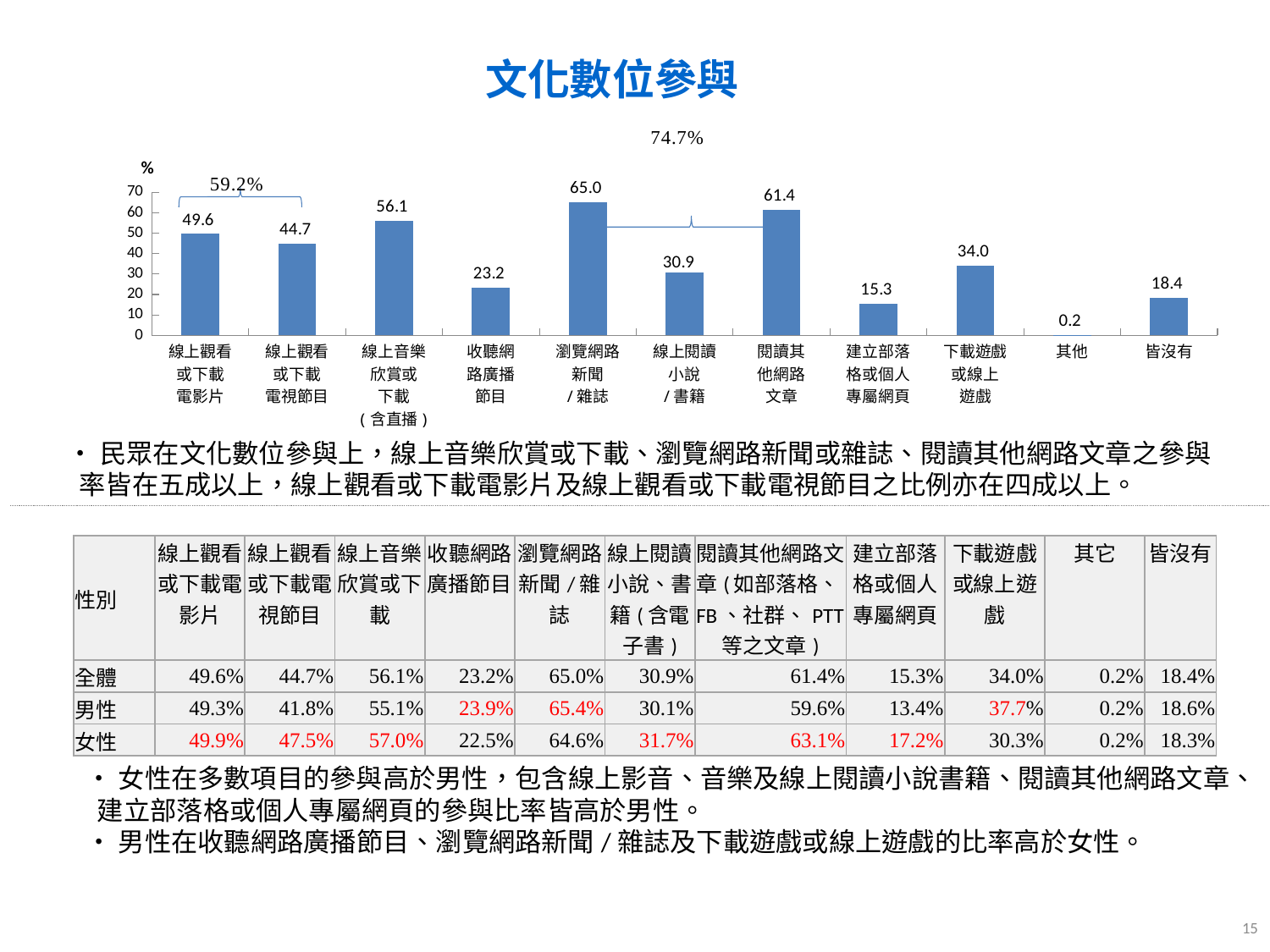
What type of chart is shown on the slide? bar chart What is the value for 線上音樂欣賞或下載(含直播) in the chart? 56.1 What is the title of the chart on the slide? 文化數位參與 How many categories are shown on the x axis of the chart? 11 What is the value for 建立部落格或個人專屬網頁 in the chart? 15.3 Which category has the lowest value in the chart? 其他 Which is larger, the value for 下載遊戲或線上遊戲 or the value for 線上閱讀小說/書籍? 下載遊戲或線上遊戲 Which category has the highest value in the chart? 瀏覽網路新聞/雜誌 What is the value for 收聽網路廣播節目 in the chart? 23.2 What is the difference between the values for 線上觀看或下載電影片 and 線上觀看或下載電視節目? 4.9 What is the difference between the values for 瀏覽網路新聞/雜誌 and 閱讀其他網路文章? 3.6 Is the value for 皆沒有 greater or less than 20? less